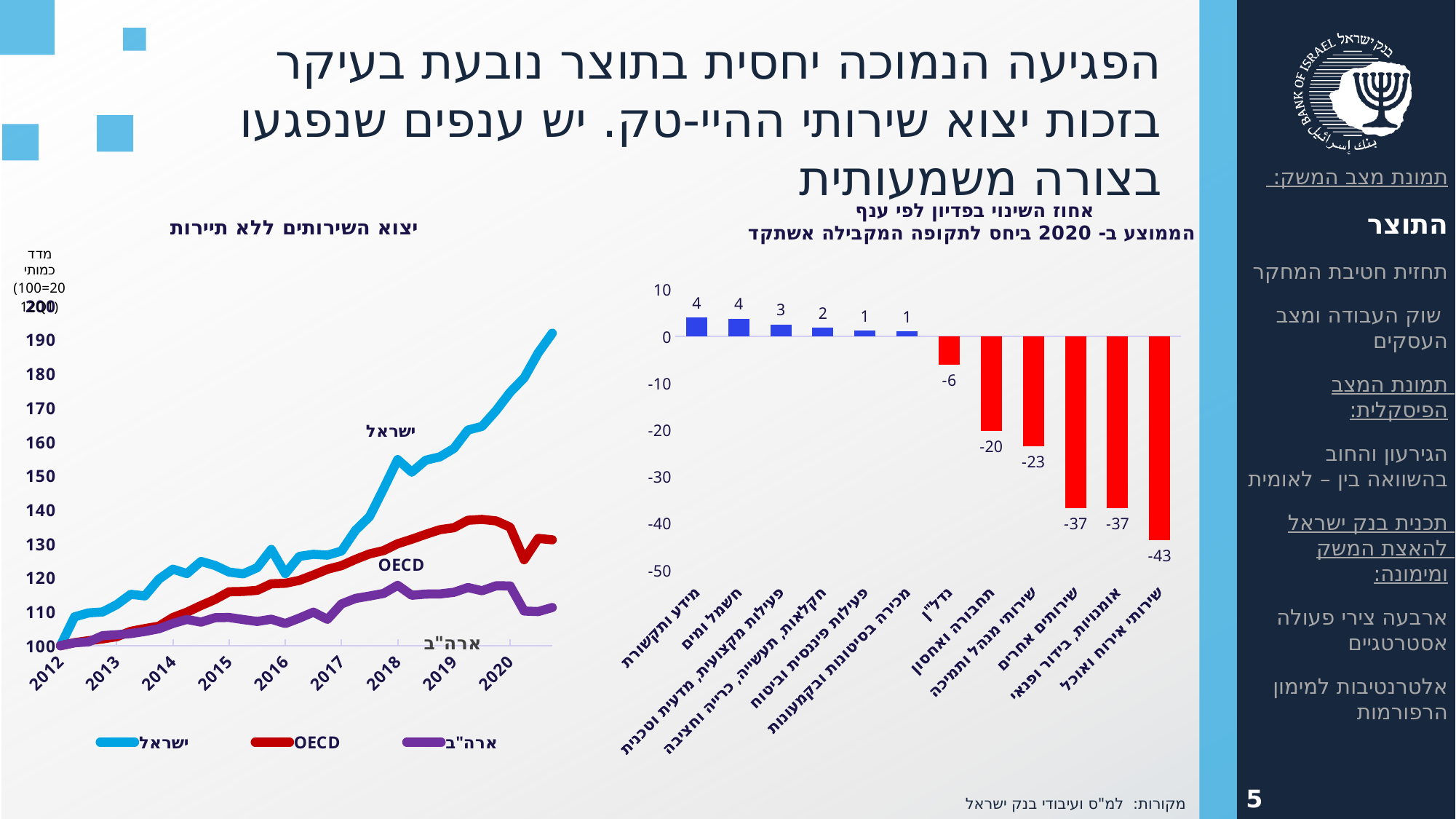
How many series does the legend of the left-hand line chart list? 3 In the right-hand bar chart, what is the value for נדל"ן? -6 In the right-hand bar chart, how many industry categories are shown? 12 In the left-hand line chart, what colour is the OECD line? red In the left-hand line chart, which series has the highest value at the end of the period? ישראל In the right-hand bar chart, which is larger: the value for מידע ותקשורת or the value for פעולות פיננסיות וביטוח? מידע ותקשורת What type of chart is the left-hand chart titled יצוא השירותים ללא תיירות? line chart In the right-hand bar chart, what is the value for תחבורה ואחסון? -20 In the left-hand line chart, is the value for ישראל at the end of the series greater or less than 180? greater In the right-hand bar chart, which industry has the lowest value? שירותי אירוח ואוכל In the right-hand bar chart, what is the difference between the values for שירותי מנהל ותמיכה and תחבורה ואחסון? 3 In the right-hand bar chart (percent change in revenue by industry, 2020), what is the value for שירותי אירוח ואוכל? -43